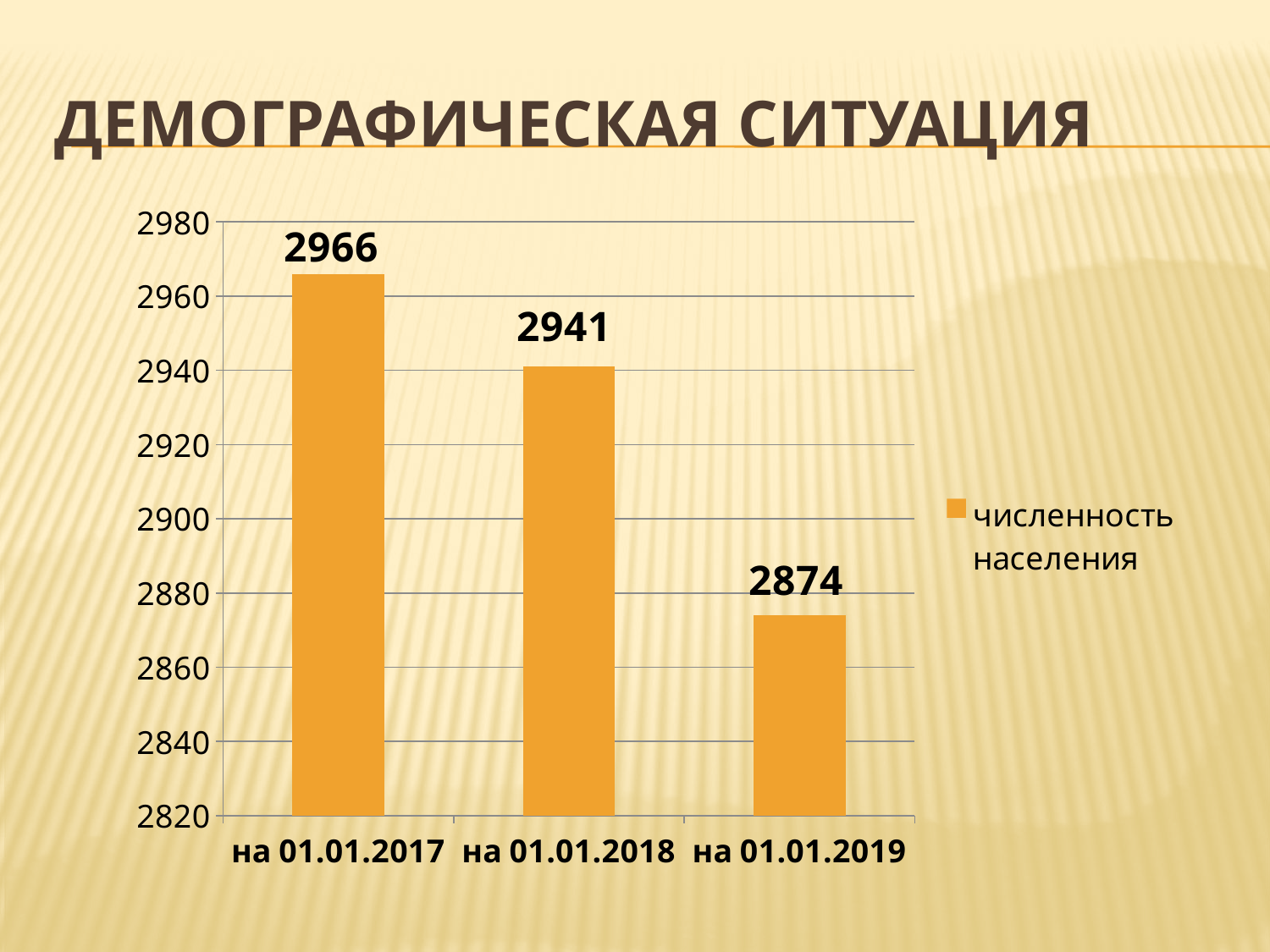
Which date has the highest population value? на 01.01.2017 What kind of chart is shown on the slide? bar chart What is the population value for на 01.01.2017? 2966 How many bars are shown in the chart? 3 Which is larger, the value for на 01.01.2018 or the value for на 01.01.2019? на 01.01.2018 What is the population value for на 01.01.2019? 2874 Is the value for на 01.01.2019 greater or less than 2900? less What is the population value for на 01.01.2018? 2941 What is the difference between the population values for на 01.01.2018 and на 01.01.2019? 67 What is the difference between the population values for на 01.01.2017 and на 01.01.2019? 92 Which date has the lowest population value? на 01.01.2019 Do the values rise or fall from на 01.01.2017 to на 01.01.2019? fall